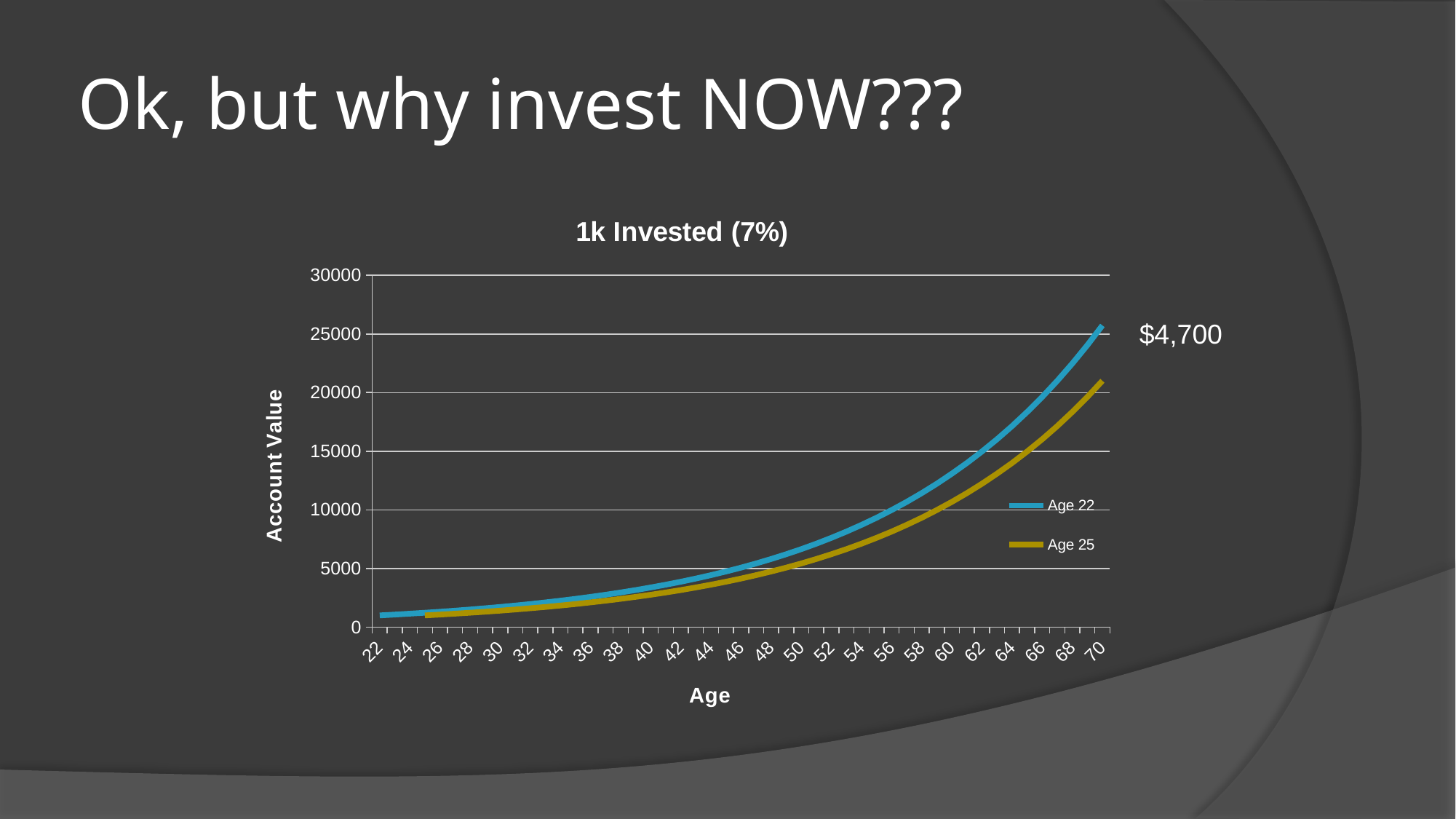
At age 70, which series has the higher account value, Age 22 or Age 25? Age 22 Do the values of the Age 22 series rise or fall as age increases along the x axis? rise Is the value for the Age 22 series at age 60 greater or less than 10000? greater Is the value for the Age 22 series at age 50 greater or less than 5000? greater What kind of chart is shown on the slide? line chart What is the label of the vertical axis of the chart? Account Value Is the value for the Age 22 series at age 70 greater or less than 30000? less Which series in the chart starts at the earliest age on the x axis? Age 22 How many series does the legend of the chart list? 2 What is the title of the chart? 1k Invested (7%)